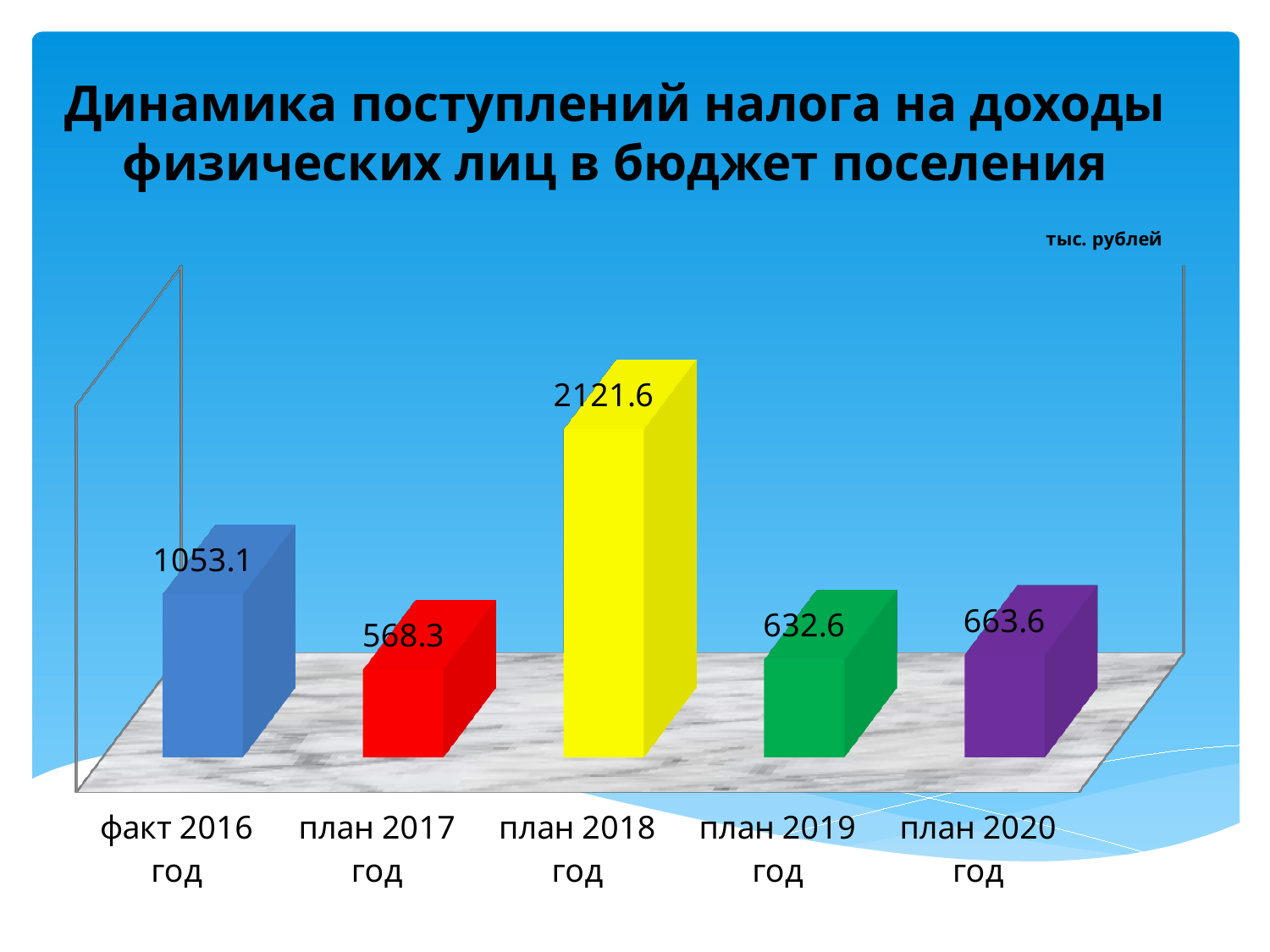
What unit is indicated for the values in the chart? тыс. рублей What is the value for план 2018 год? 2121.6 How many categories are shown in the chart? 5 What kind of chart is shown on the slide? bar chart Which category has the highest value? план 2018 год Which category has the lowest value? план 2017 год What is the value for план 2020 год? 663.6 Do the values rise or fall from план 2018 год to план 2019 год? fall What is the difference between the values for план 2018 год and факт 2016 год? 1068.5 Which is larger, the value for факт 2016 год or the value for план 2017 год? факт 2016 год What is the difference between the values for план 2020 год and план 2019 год? 31 What is the value for факт 2016 год? 1053.1